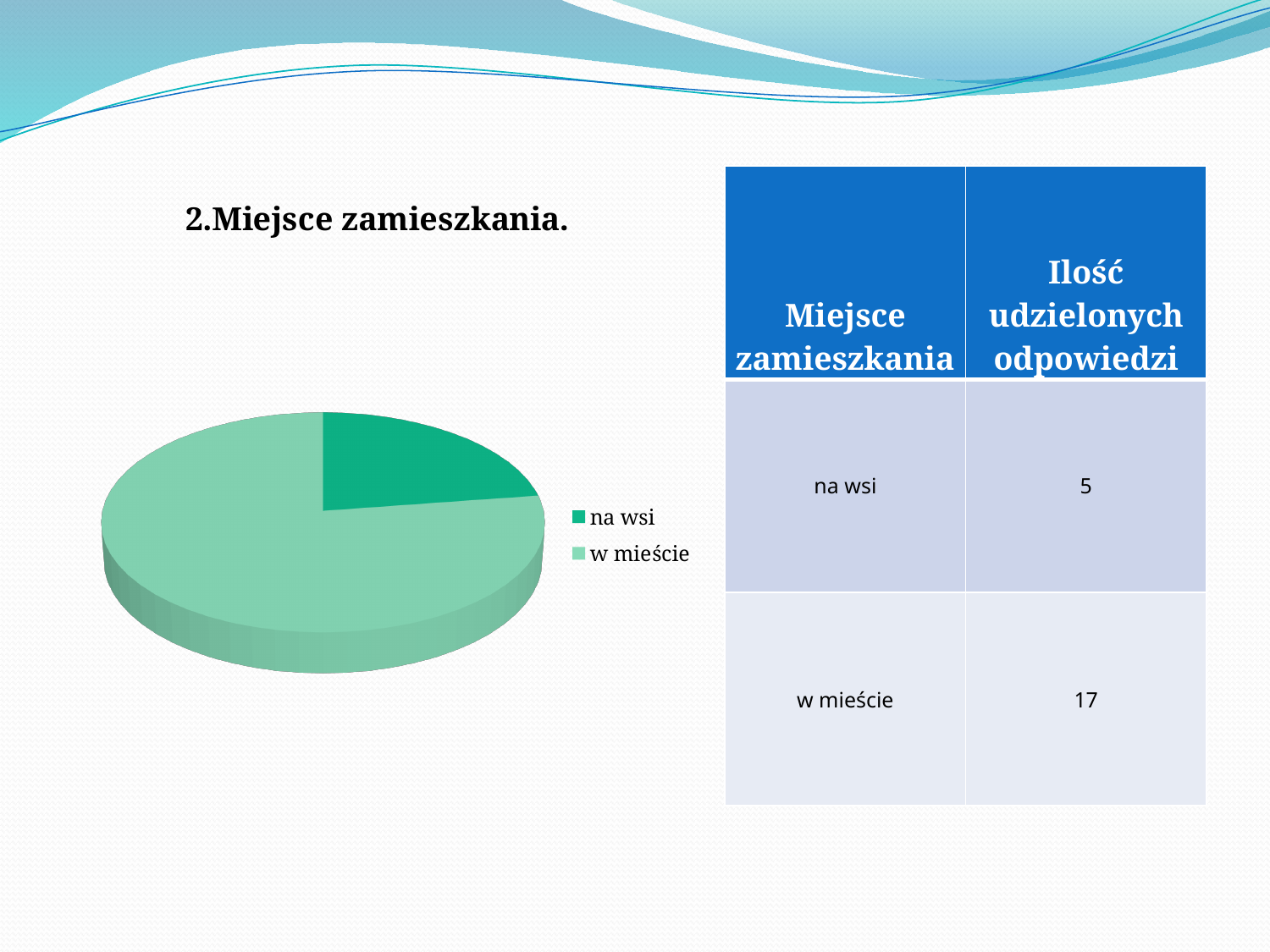
Using the values in the table, what is the total number of responses shown in the pie chart? 22 According to the table next to the pie chart, how many responses were given for "na wsi"? 5 Using the values in the table, how many more responses were given for "w mieście" than for "na wsi"? 12 What is the title shown above the pie chart? 2.Miejsce zamieszkania. Which legend entry is shown in the darker green colour? na wsi How many slices does the pie chart have? 2 Which category has the largest slice of the pie chart? w mieście Which slice is larger in the pie chart, "na wsi" or "w mieście"? w mieście How many entries does the pie chart's legend list? 2 What kind of chart is shown on the slide? pie chart Which category has the smallest slice of the pie chart? na wsi According to the table next to the pie chart, how many responses were given for "w mieście"? 17